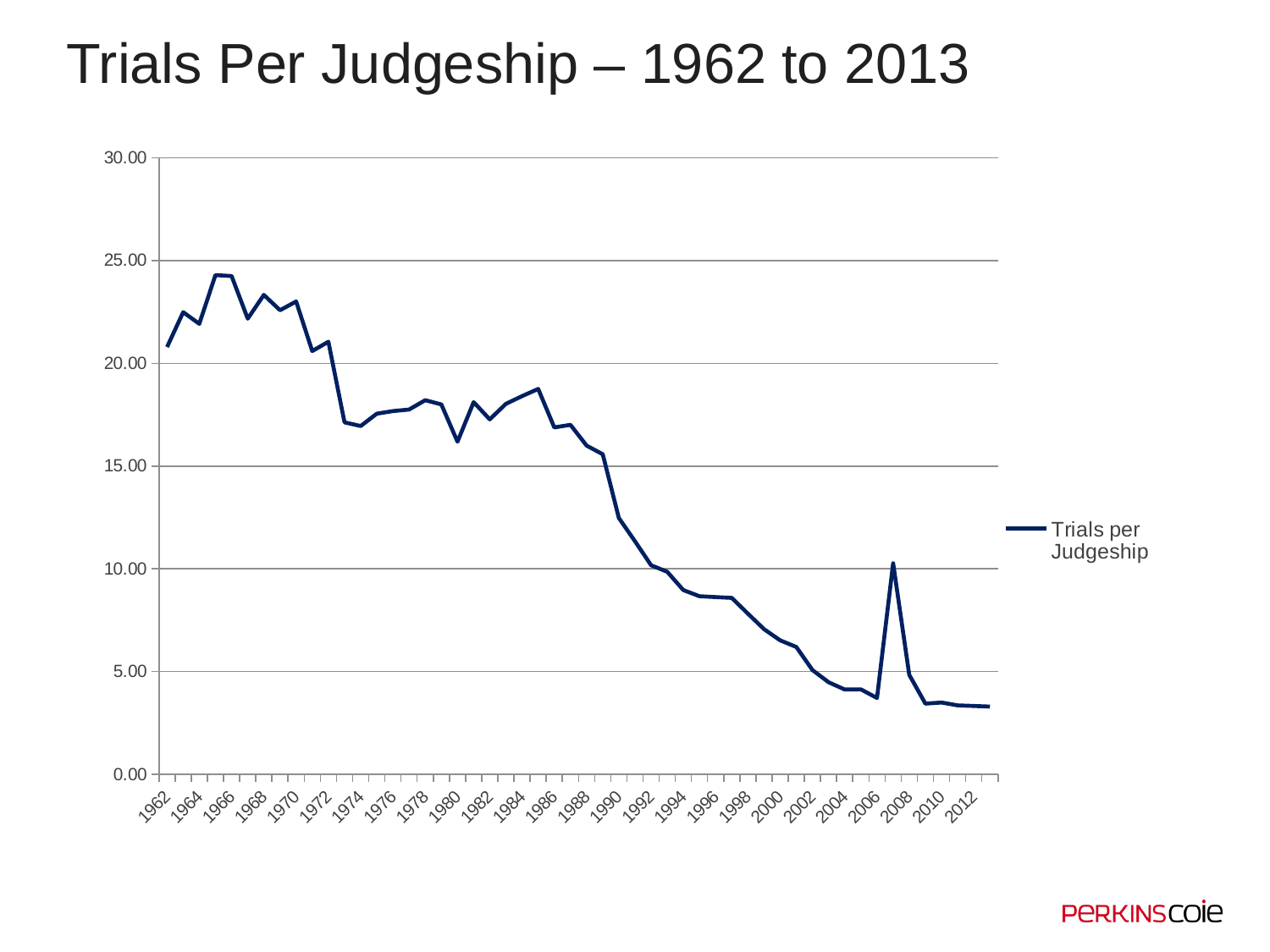
Which year has the larger value, 1986 or 1994? 1986 What is the title of the chart? Trials Per Judgeship – 1962 to 2013 How many series does the legend list? 1 What is the name of the series shown in the legend? Trials per Judgeship Is the value for 1996 greater or less than 10.00? less Is the value for 1990 greater or less than 15.00? less What kind of chart is shown on the slide? line chart Is the value for 1962 greater or less than 20.00? greater Which year has the larger value, 1966 or 2012? 1966 Overall, do the values rise or fall from 1962 to 2013? fall